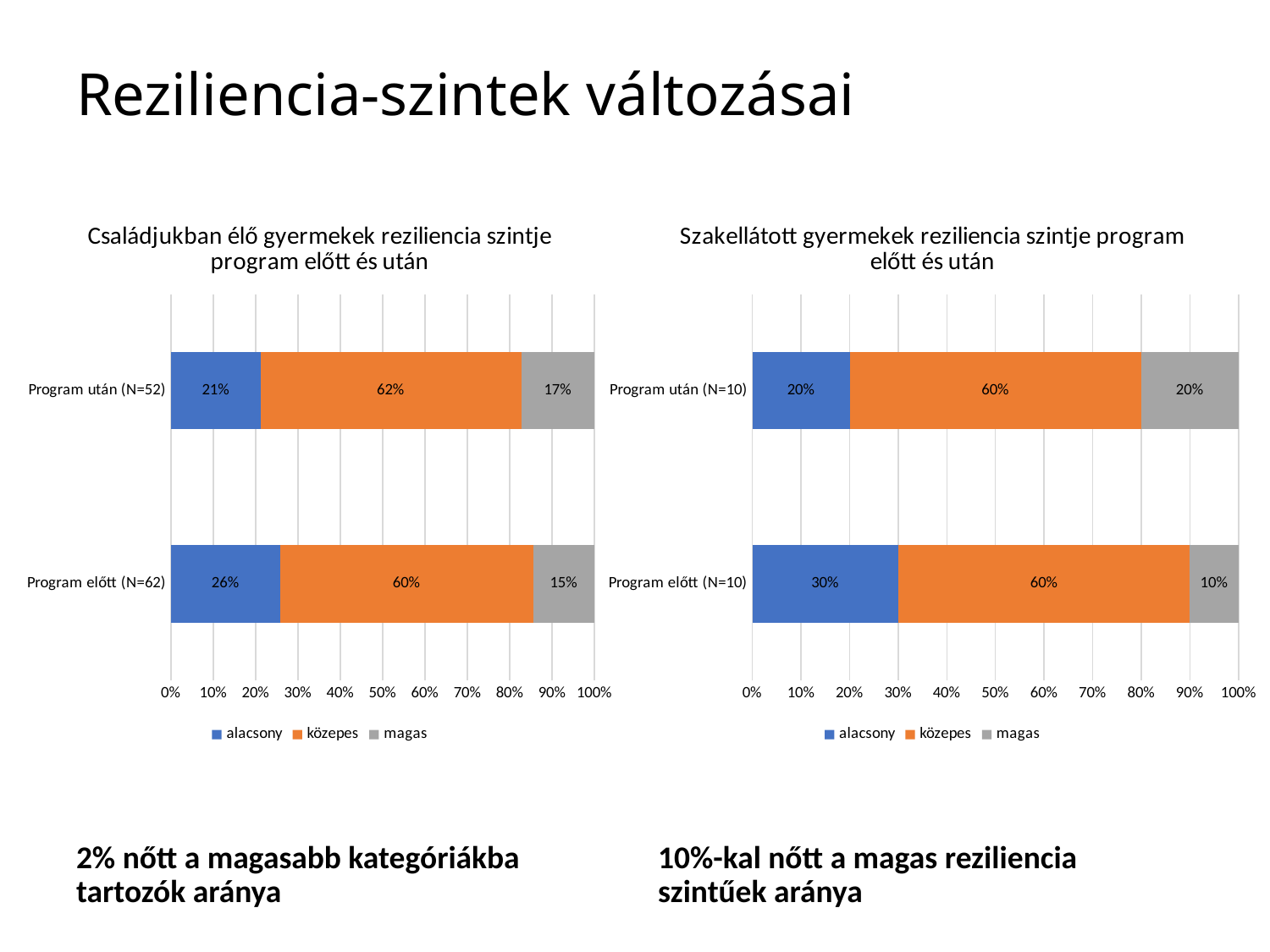
In the right chart (Szakellátott gyermekek), which category has the higher 'alacsony' value? Program előtt (N=10) In the left chart (Családjukban élő gyermekek), what is the 'magas' value for 'Program előtt (N=62)'? 15% What kind of chart is the left chart (Családjukban élő gyermekek)? Stacked bar chart How many series does the legend of the left chart (Családjukban élő gyermekek) list? 3 In the left chart (Családjukban élő gyermekek), what is the 'alacsony' value for 'Program után (N=52)'? 21% In the right chart (Szakellátott gyermekek), which colour represents the 'közepes' series? Orange In the left chart (Családjukban élő gyermekek), what is the difference between the 'alacsony' values for 'Program előtt (N=62)' and 'Program után (N=52)'? 5% How many categories are shown in the right chart (Szakellátott gyermekek)? 2 In the right chart (Szakellátott gyermekek), what is the 'alacsony' value for 'Program előtt (N=10)'? 30% In the left chart (Családjukban élő gyermekek), which is larger: the 'magas' value for 'Program után (N=52)' or for 'Program előtt (N=62)'? Program után (N=52) In the right chart (Szakellátott gyermekek), what is the difference between the 'magas' values for 'Program után (N=10)' and 'Program előtt (N=10)'? 10% In the right chart (Szakellátott gyermekek), what is the 'magas' value for 'Program után (N=10)'? 20%